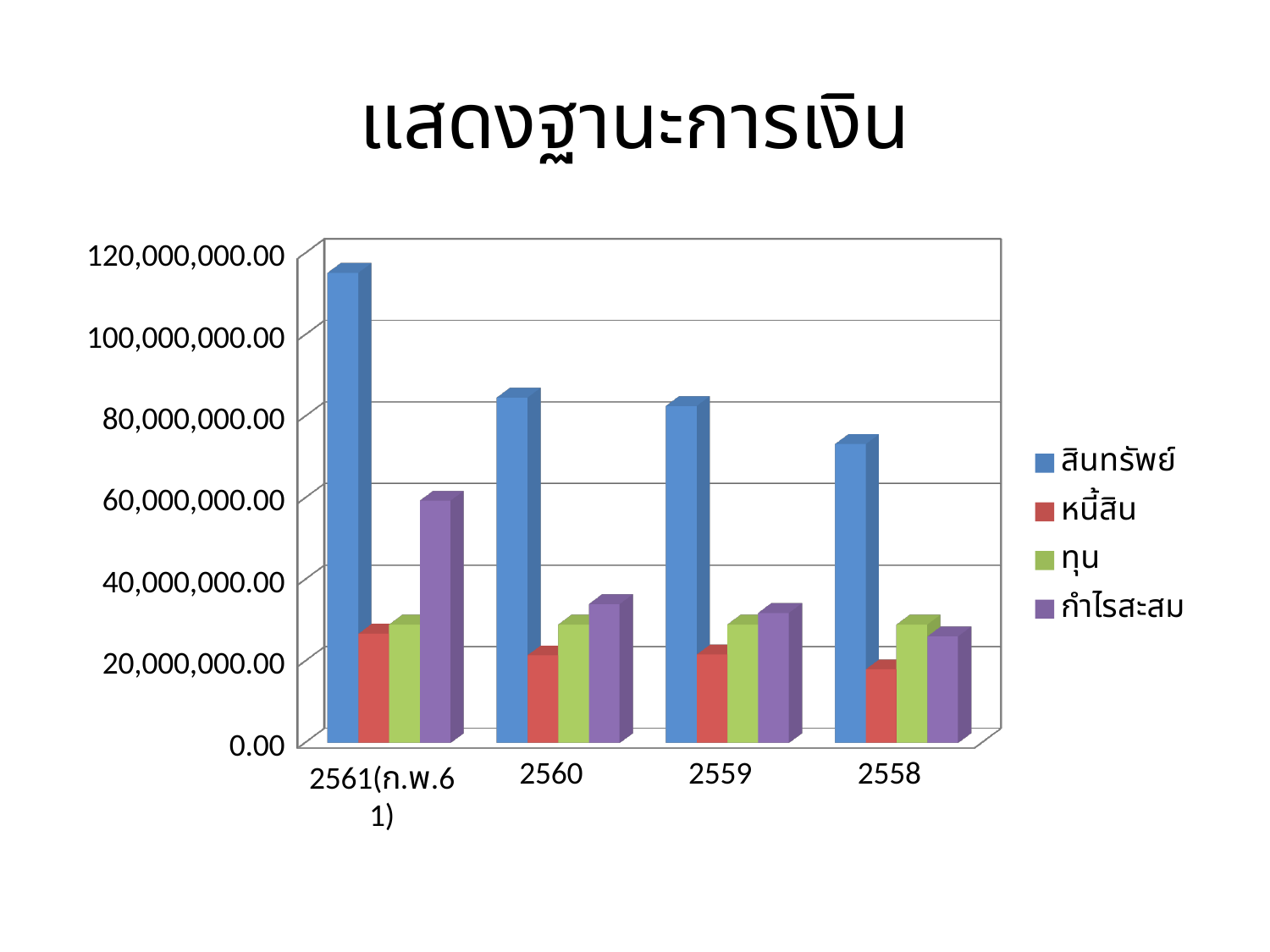
What is the title of the chart? แสดงฐานะการเงิน How many categories are shown on the x axis? 4 Is the value for กำไรสะสม in 2561(ก.พ.61) greater or less than 40,000,000.00? greater Which series is shown in blue in the legend? สินทรัพย์ Is the value for สินทรัพย์ in 2561(ก.พ.61) greater or less than 100,000,000.00? greater Which is larger, the value for กำไรสะสม in 2561(ก.พ.61) or in 2560? 2561(ก.พ.61) In which category is the value for สินทรัพย์ highest? 2561(ก.พ.61) What kind of chart is shown on the slide? bar chart Is the value for หนี้สิน in 2558 greater or less than 20,000,000.00? less How many series does the legend list? 4 In which category is the value for สินทรัพย์ lowest? 2558 Do the values for สินทรัพย์ rise or fall from left to right along the x axis? fall